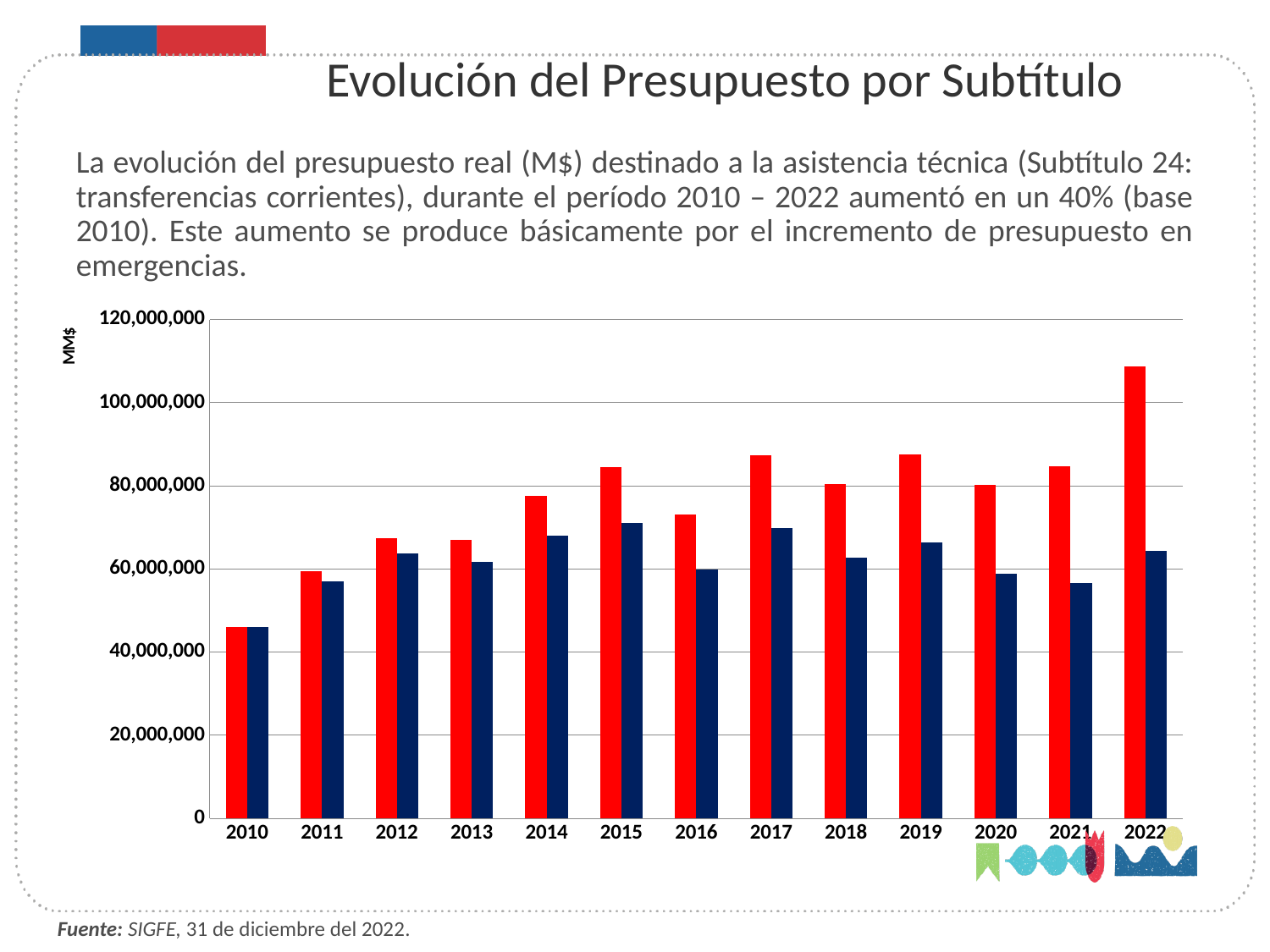
What label is shown on the vertical axis of the chart? MM$ Is the value of the dark blue bar for 2021 greater or less than 60,000,000? less Is the value of the red bar for 2010 greater or less than 60,000,000? less Is the value of the red bar for 2017 greater or less than 80,000,000? greater What kind of chart is shown on the slide? bar chart In which year is the red bar the shortest? 2010 In 2022, which bar is taller, the red bar or the dark blue bar? the red bar In which year is the dark blue bar the shortest? 2010 How many bars are plotted for each year in the chart? 2 In which year is the red bar the tallest? 2022 How many years are shown on the x axis of the chart? 13